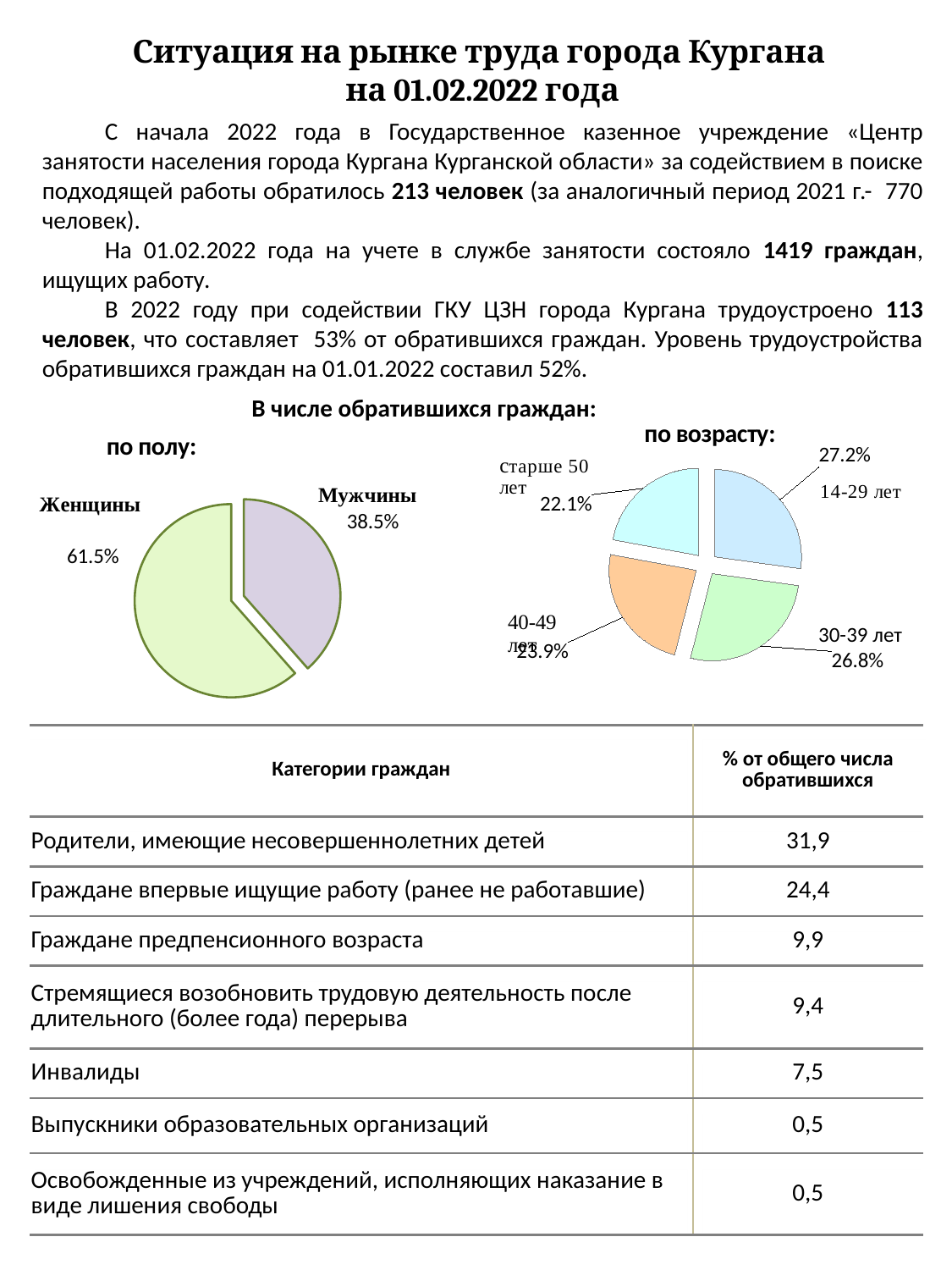
In the pie chart "по возрасту", which age group has the smallest share? старше 50 лет In the pie chart "по возрасту", what share is shown for 30-39 лет? 26.8% What kind of chart is used for "по возрасту"? Pie chart In the pie chart "по возрасту", what is the difference in percentage points between 40-49 лет and старше 50 лет? 1.8 percentage points In the pie chart "по возрасту", what share is shown for 14-29 лет? 27.2% In the pie chart "по полу", how many slices are there? 2 In the pie chart "по полу", what share is shown for Мужчины? 38.5% In the pie chart "по возрасту", how many age groups are shown? 4 In the pie chart "по возрасту", what share is shown for старше 50 лет? 22.1% In the pie chart "по полу", what is the difference in percentage points between Женщины and Мужчины? 23 percentage points In the pie chart "по полу", what share is shown for Женщины? 61.5% In the pie chart "по полу", which category has the larger share? Женщины